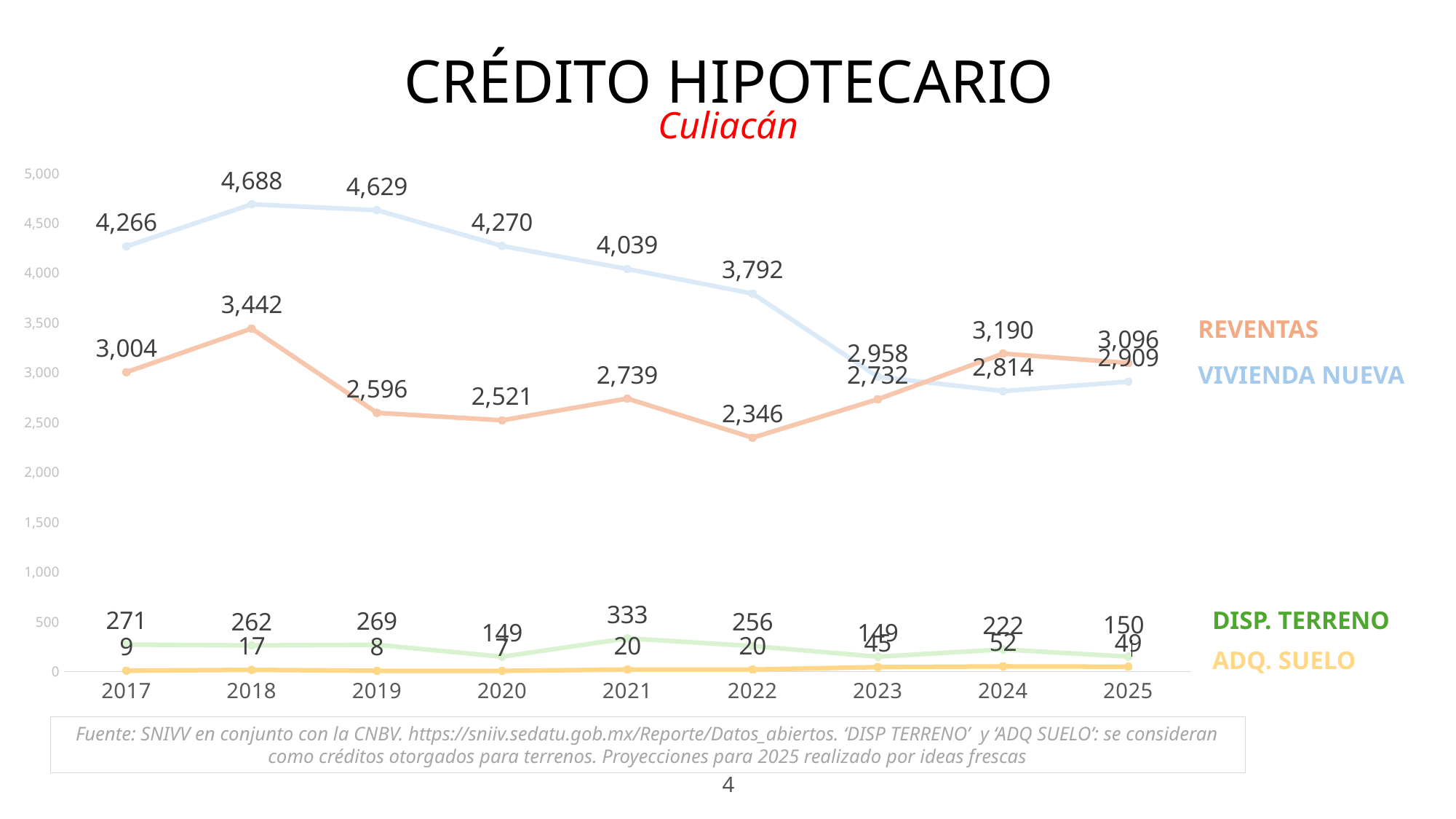
How many series does the chart show? 4 What kind of chart is shown on the slide? Line chart What is the value for VIVIENDA NUEVA in 2018? 4,688 What is the value for REVENTAS in 2022? 2,346 In which year is ADQ. SUELO highest? 2024 In 2024, which is larger: REVENTAS or VIVIENDA NUEVA? REVENTAS In which year is REVENTAS lowest? 2022 In which year is VIVIENDA NUEVA highest? 2018 What is the difference between VIVIENDA NUEVA in 2018 and in 2017? 422 Does VIVIENDA NUEVA rise or fall from 2018 to 2023? Fall How many years are shown on the x axis? 9 What is the value for DISP. TERRENO in 2021? 333